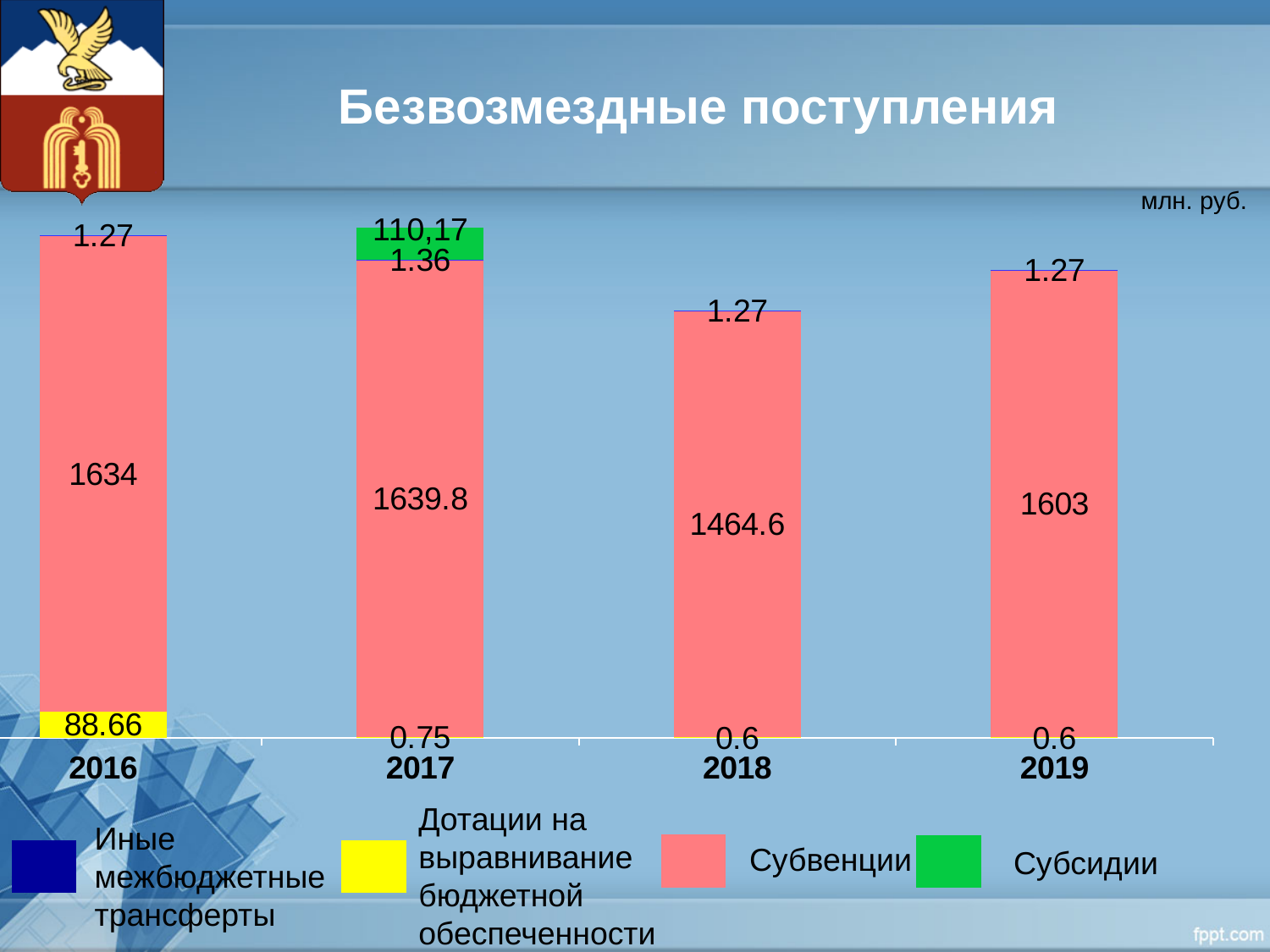
In which year is the value of Субвенции the highest? 2017 What is the value of Дотации на выравнивание бюджетной обеспеченности for 2016? 88.66 What is the value of Субсидии for 2017? 110,17 What kind of chart is shown on the slide? Stacked bar chart What is the value of Субвенции for 2018? 1464.6 In which year is the value of Субвенции the lowest? 2018 How many years are shown on the x axis? 4 What is the value of Субвенции for 2019? 1603 What is the difference between the Субвенции values for 2016 and 2018? 169.4 Which is larger, the Субвенции value for 2017 or for 2019? 2017 What is the total of the stacked bar for 2018? 1466.47 How many series does the legend list? 4